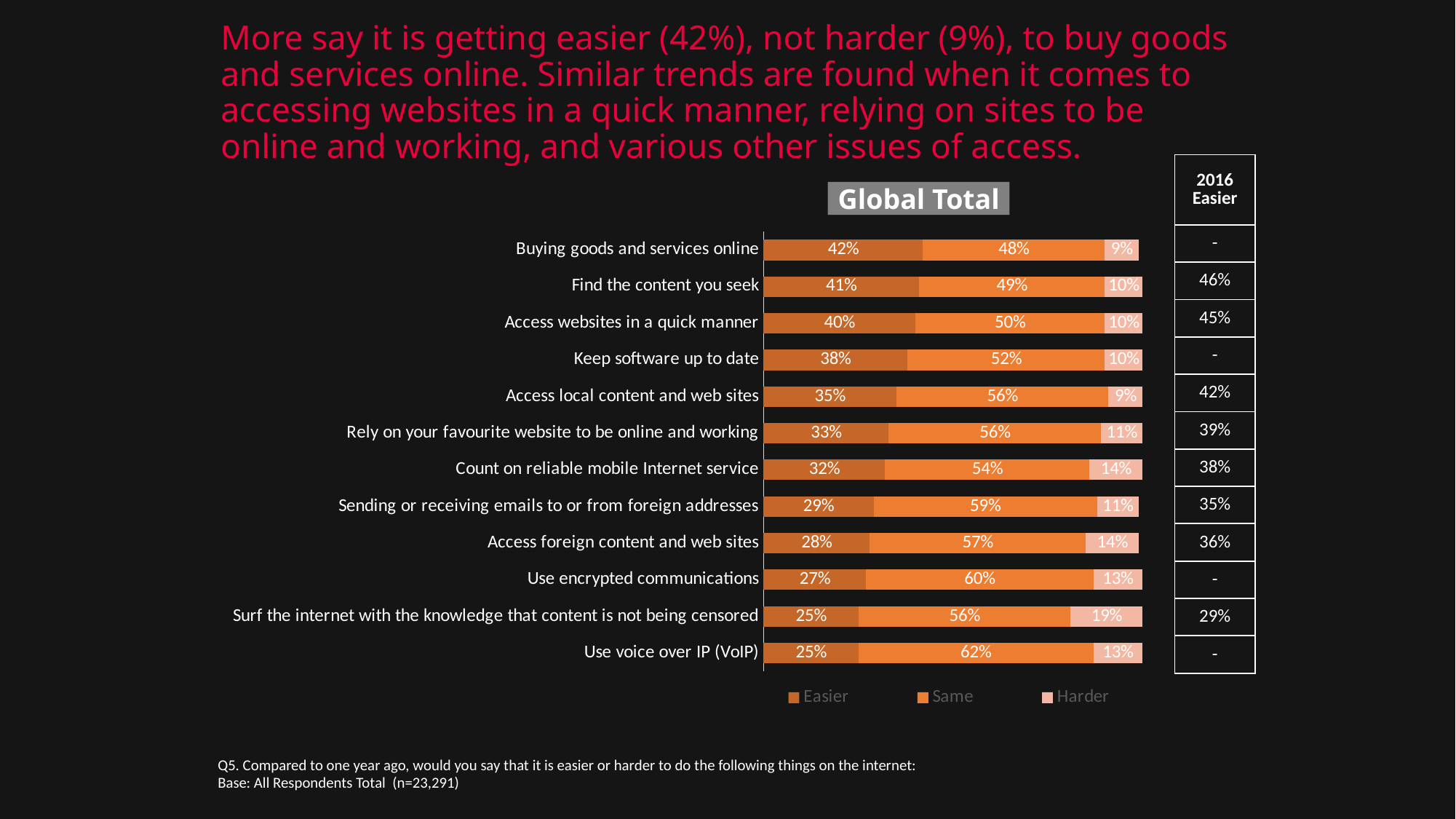
Which category has the lowest 'Same' percentage? Buying goods and services online What percentage say it is easier to buy goods and services online? 42% What kind of chart is shown on the slide? Stacked bar chart Which category has the highest 'Harder' percentage? Surf the internet with the knowledge that content is not being censored Which category has the highest 'Easier' percentage? Buying goods and services online What percentage say it is harder to surf the internet with the knowledge that content is not being censored? 19% How many categories are shown in the chart? 12 What is the title of the chart? Global Total Which is larger: the 'Easier' value for Keep software up to date or for Access local content and web sites? Keep software up to date What is the difference between the 'Easier' and 'Harder' percentages for Buying goods and services online? 33 percentage points How many series does the legend list? 3 What is the 'Same' value for Use voice over IP (VoIP)? 62%